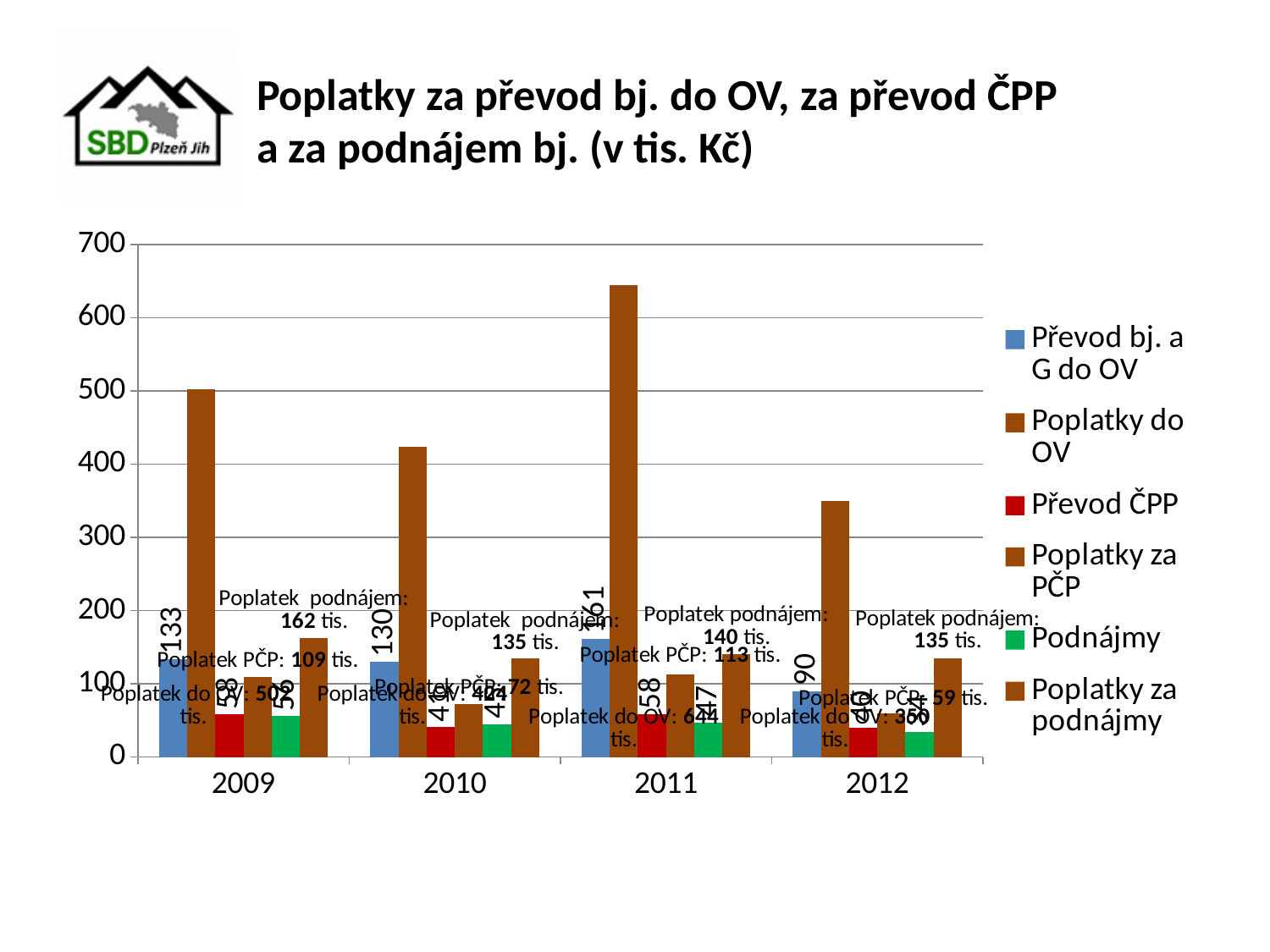
What kind of chart is shown on the slide? bar chart In which year is 'Převod bj. a G do OV' the lowest? 2012 What is the difference between 'Poplatek do OV' in 2011 and in 2009? 142 tis. How many series does the chart legend list? 6 Which year has the larger 'Poplatek PČP' value, 2009 or 2011? 2011 Is the value for 'Poplatky do OV' in 2010 greater or less than 400? greater How many years are shown on the x axis of the chart? 4 What is the 'Poplatek podnájem' value shown for 2009? 162 tis. What is the value of 'Převod bj. a G do OV' in 2009? 133 What is the 'Poplatek do OV' value shown for 2012? 350 tis. In which year is 'Poplatky do OV' the highest? 2011 What is the value of 'Převod bj. a G do OV' in 2011? 161